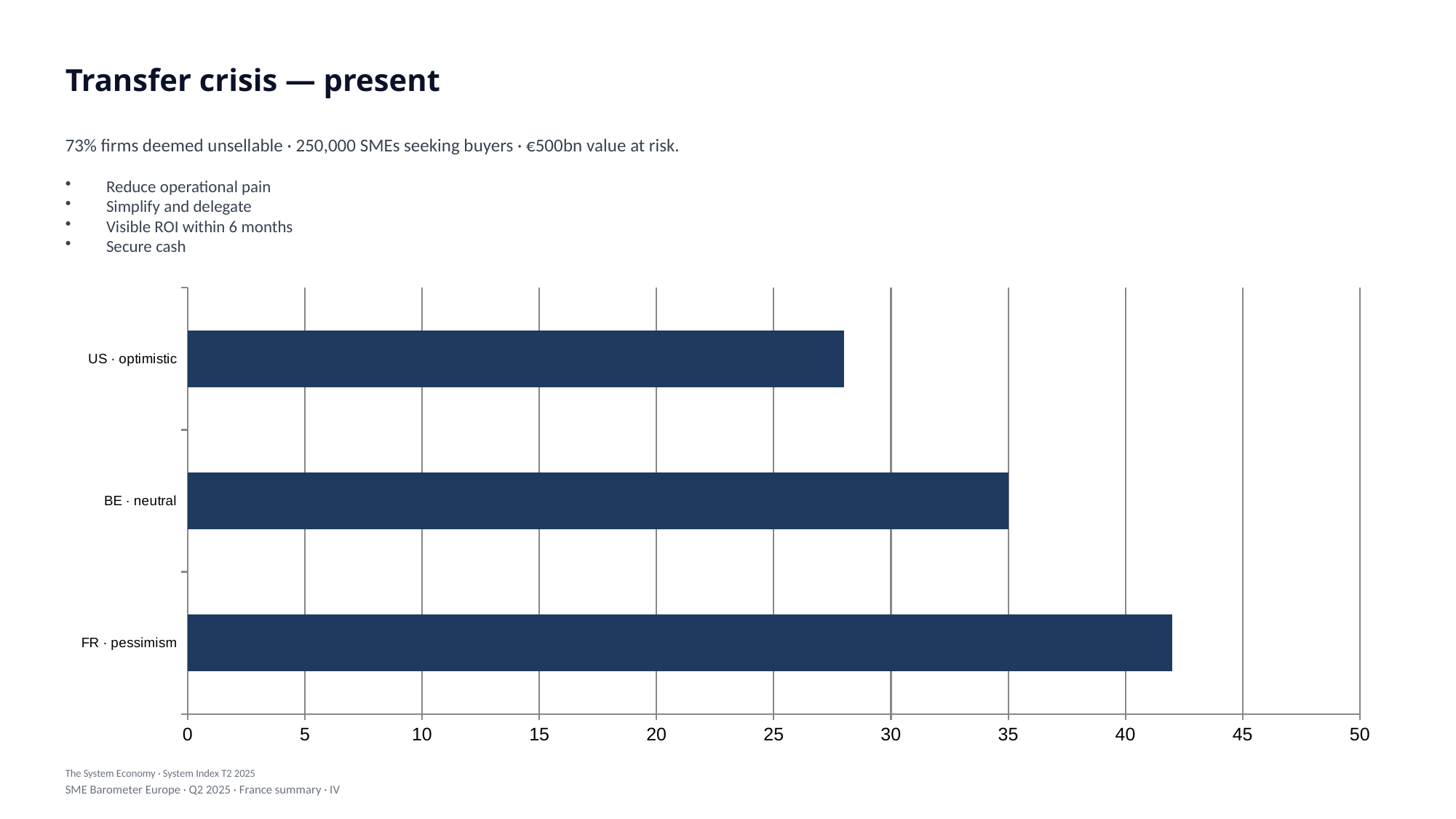
Which category has the highest value? FR · pessimism What is the maximum value shown on the horizontal axis? 50 Is the value for US · optimistic greater or less than 25? greater Is the value for US · optimistic greater or less than 30? less Is the value for FR · pessimism greater or less than 45? less What is the value for BE · neutral? 35 Which is larger, the value for FR · pessimism or the value for BE · neutral? FR · pessimism Which category has the lowest value? US · optimistic How many categories does the chart show? 3 What type of chart is shown on the slide? bar chart Which is larger, the value for BE · neutral or the value for US · optimistic? BE · neutral